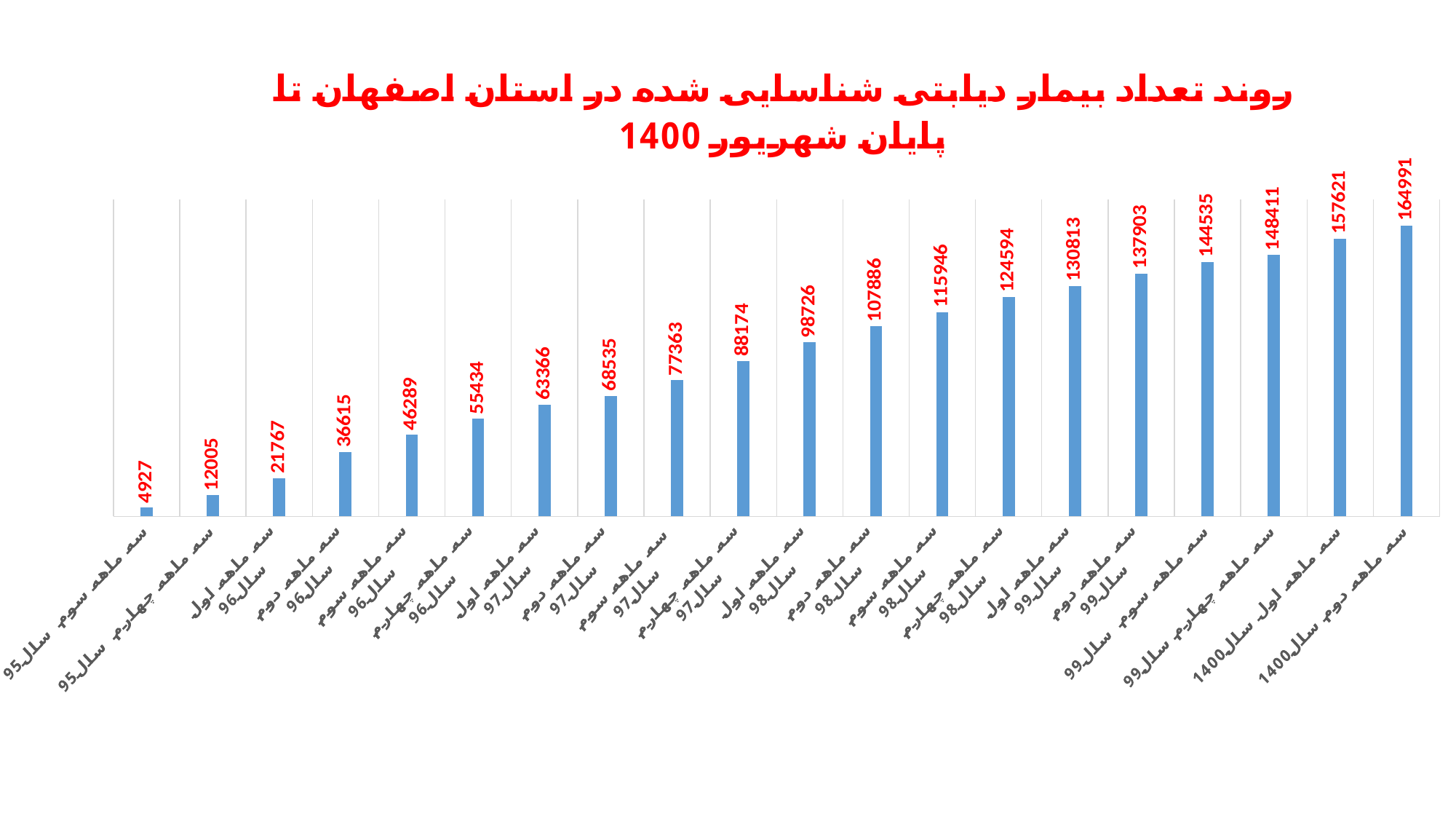
How many bars are shown in the chart? 20 What is the value for سه ماهه اول سال98? 98726 Which category has the lowest value? سه ماهه سوم سال95 What is the value for سه ماهه سوم سال95? 4927 Which is larger, the value for سه ماهه سوم سال99 or the value for سه ماهه اول سال99? سه ماهه سوم سال99 Do the values rise or fall from left to right along the x axis? rise What is the difference between the values for سه ماهه دوم سال1400 and سه ماهه اول سال1400? 7370 What is the difference between the values for سه ماهه چهارم سال95 and سه ماهه سوم سال95? 7078 What is the value for سه ماهه دوم سال1400? 164991 Which category has the highest value? سه ماهه دوم سال1400 What kind of chart is shown on the slide? bar chart What is the value for سه ماهه چهارم سال97? 88174